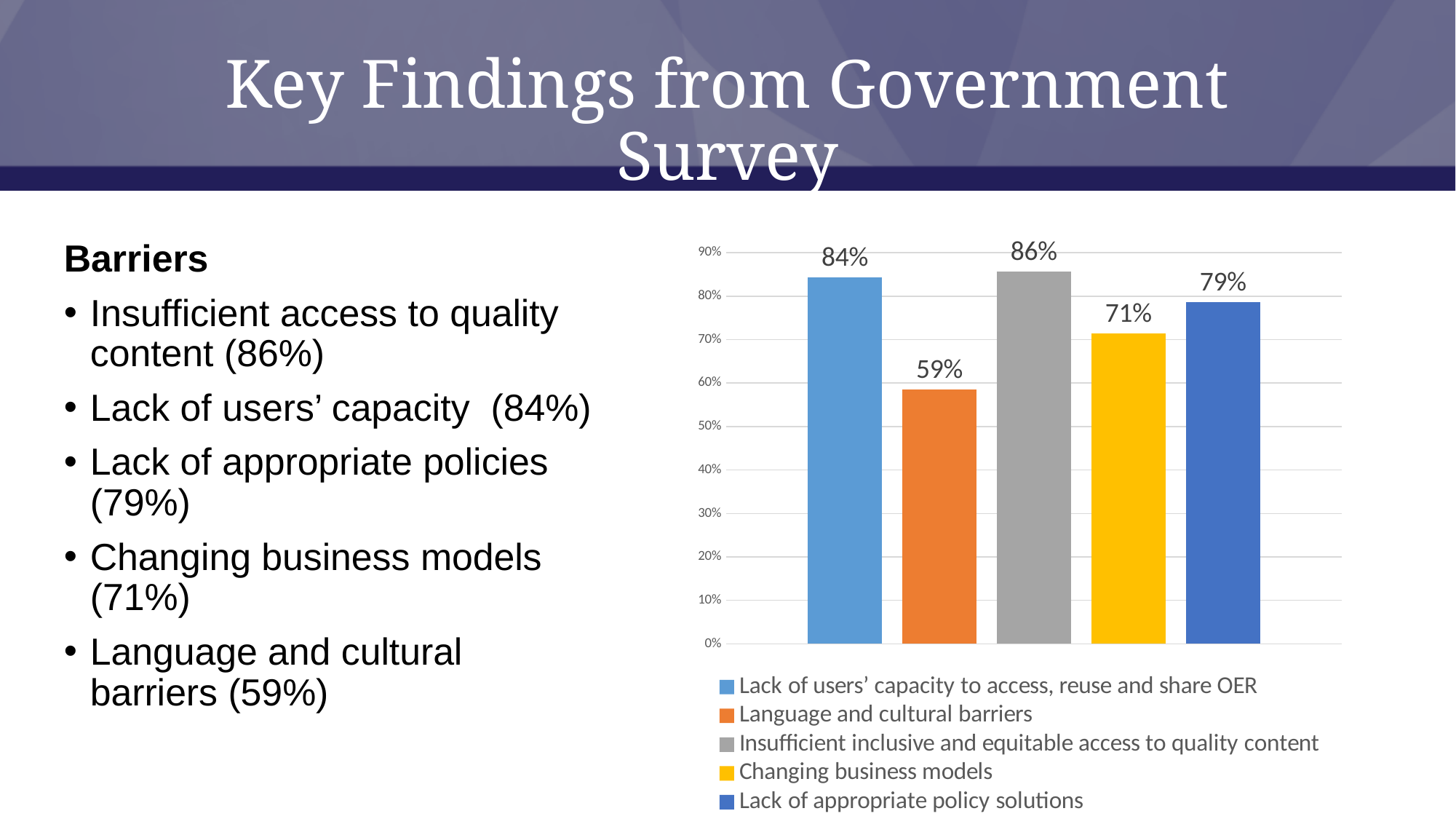
What is the value for Lack of users' capacity to access, reuse and share OER? 84% What kind of chart is shown on the slide? bar chart What is the value for Lack of appropriate policy solutions? 79% What is the difference between the values for Insufficient inclusive and equitable access to quality content and Language and cultural barriers? 27% Which barrier has the highest value? Insufficient inclusive and equitable access to quality content Is the value for Language and cultural barriers greater or less than 60%? less What is the value for Changing business models? 71% Which barrier has the lowest value? Language and cultural barriers How many bars are shown in the chart? 5 How many entries does the legend list? 5 What is the value for Language and cultural barriers? 59% Which is larger, the value for Changing business models or the value for Lack of appropriate policy solutions? Lack of appropriate policy solutions